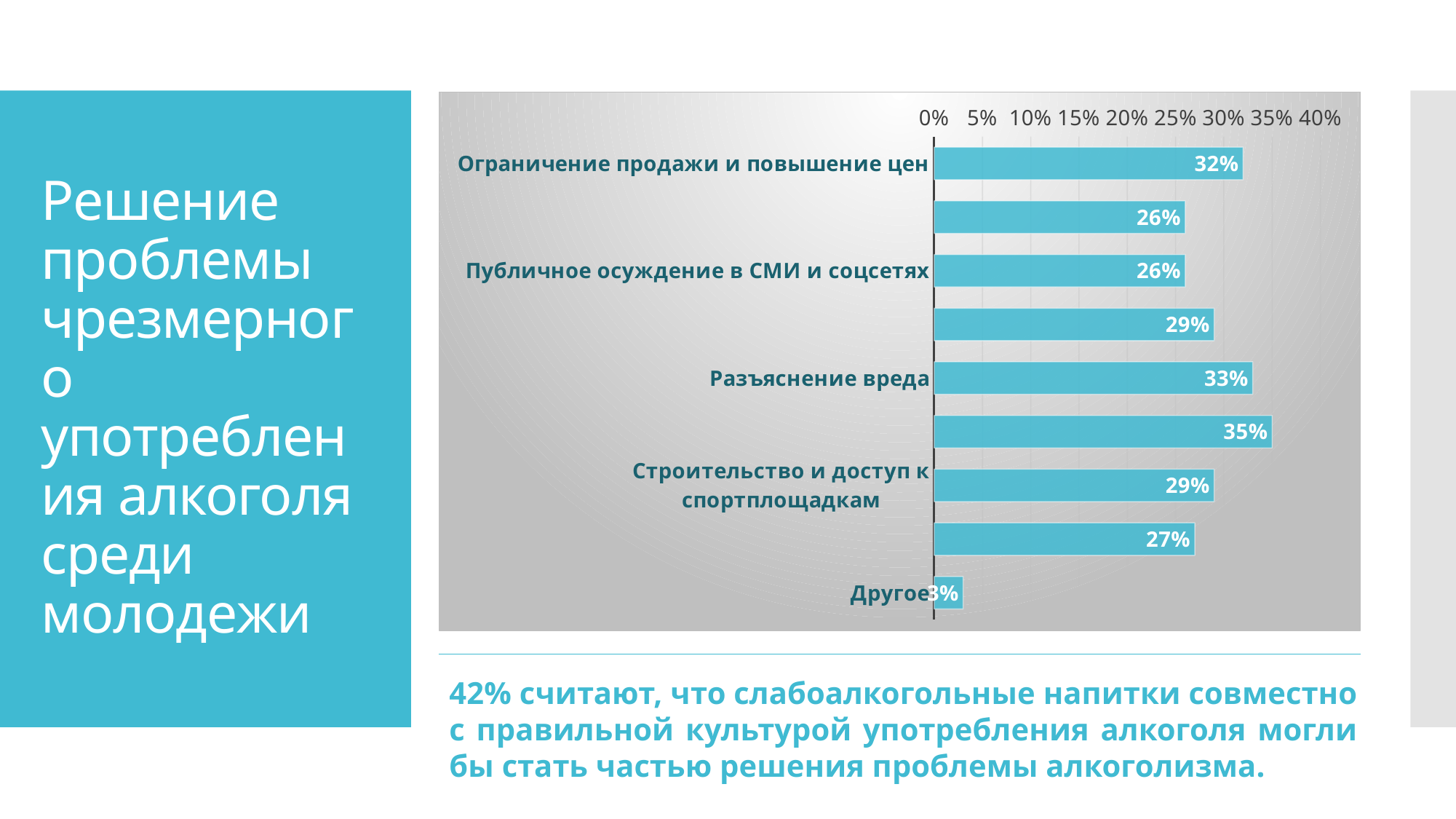
Which is larger, the value for "Ограничение продажи и повышение цен" or the value for "Строительство и доступ к спортплощадкам"? Ограничение продажи и повышение цен What is the difference between the values for "Разъяснение вреда" and "Публичное осуждение в СМИ и соцсетях"? 7% What kind of chart is shown on the slide? bar chart What is the value for "Разъяснение вреда"? 33% What is the value for "Публичное осуждение в СМИ и соцсетях"? 26% How many bars are plotted in the chart? 9 What is the value for "Строительство и доступ к спортплощадкам"? 29% What is the highest value shown on the horizontal axis of the chart? 40% What is the difference between the values for "Ограничение продажи и повышение цен" and "Другое"? 29% Which category has the lowest value? Другое What is the value for "Другое"? 3% What is the value for "Ограничение продажи и повышение цен"? 32%